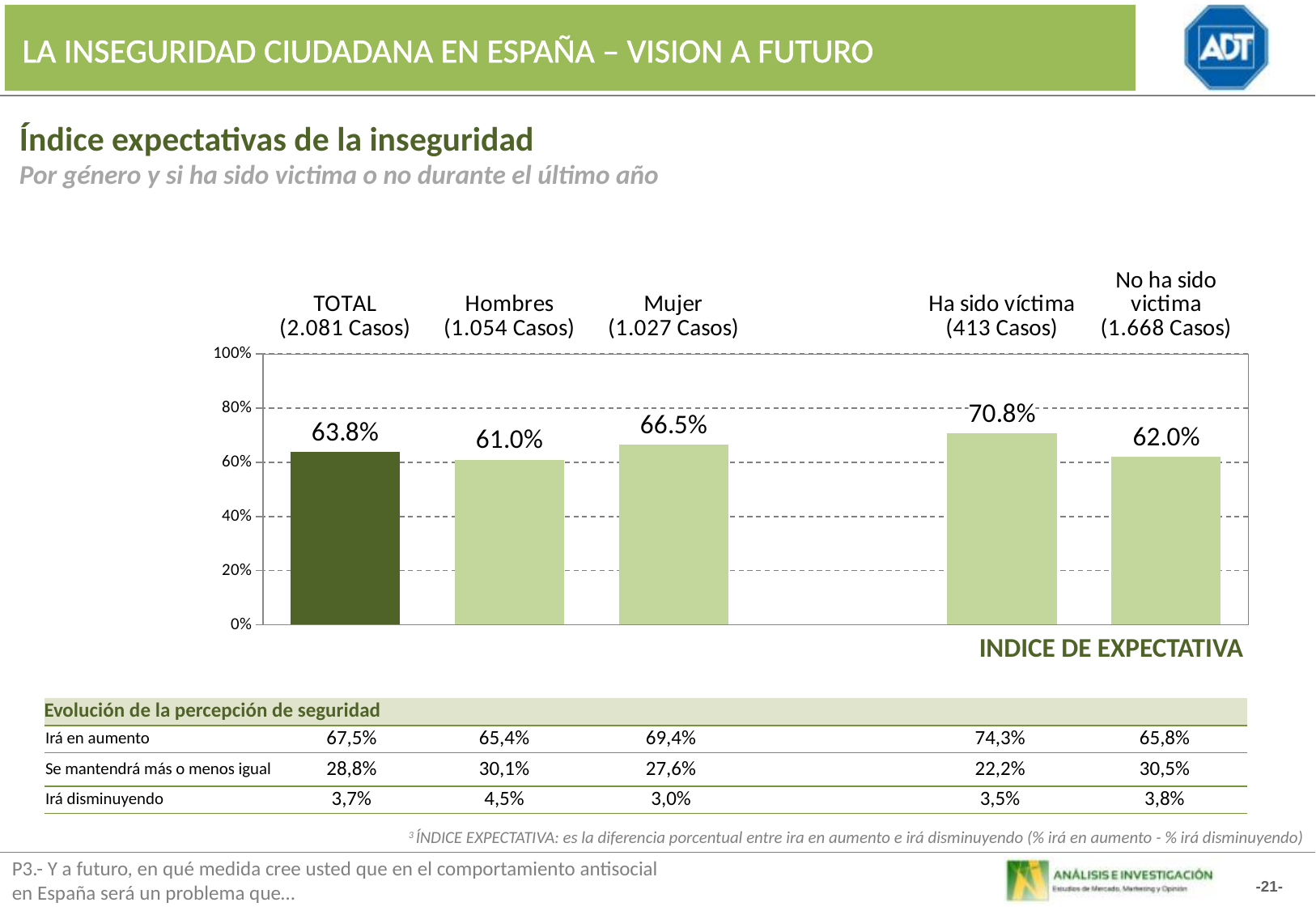
Which category has the highest bar in the chart? Ha sido víctima What kind of chart is shown on the slide? Bar chart Is the value for Ha sido víctima greater or less than 60%? greater What is the value of the bar for Ha sido víctima (413 Casos)? 70.8% Which is larger, the value for Mujer or the value for Hombres? Mujer What is the value of the bar for Mujer (1.027 Casos)? 66.5% What is the difference between the values for Ha sido víctima and No ha sido víctima? 8.8% Which category has the lowest bar in the chart? Hombres What is the value of the bar for No ha sido víctima (1.668 Casos)? 62.0% What is the value of the bar for Hombres (1.054 Casos)? 61.0% What is the value of the bar for TOTAL (2.081 Casos)? 63.8% How many bars are plotted in the chart? 5